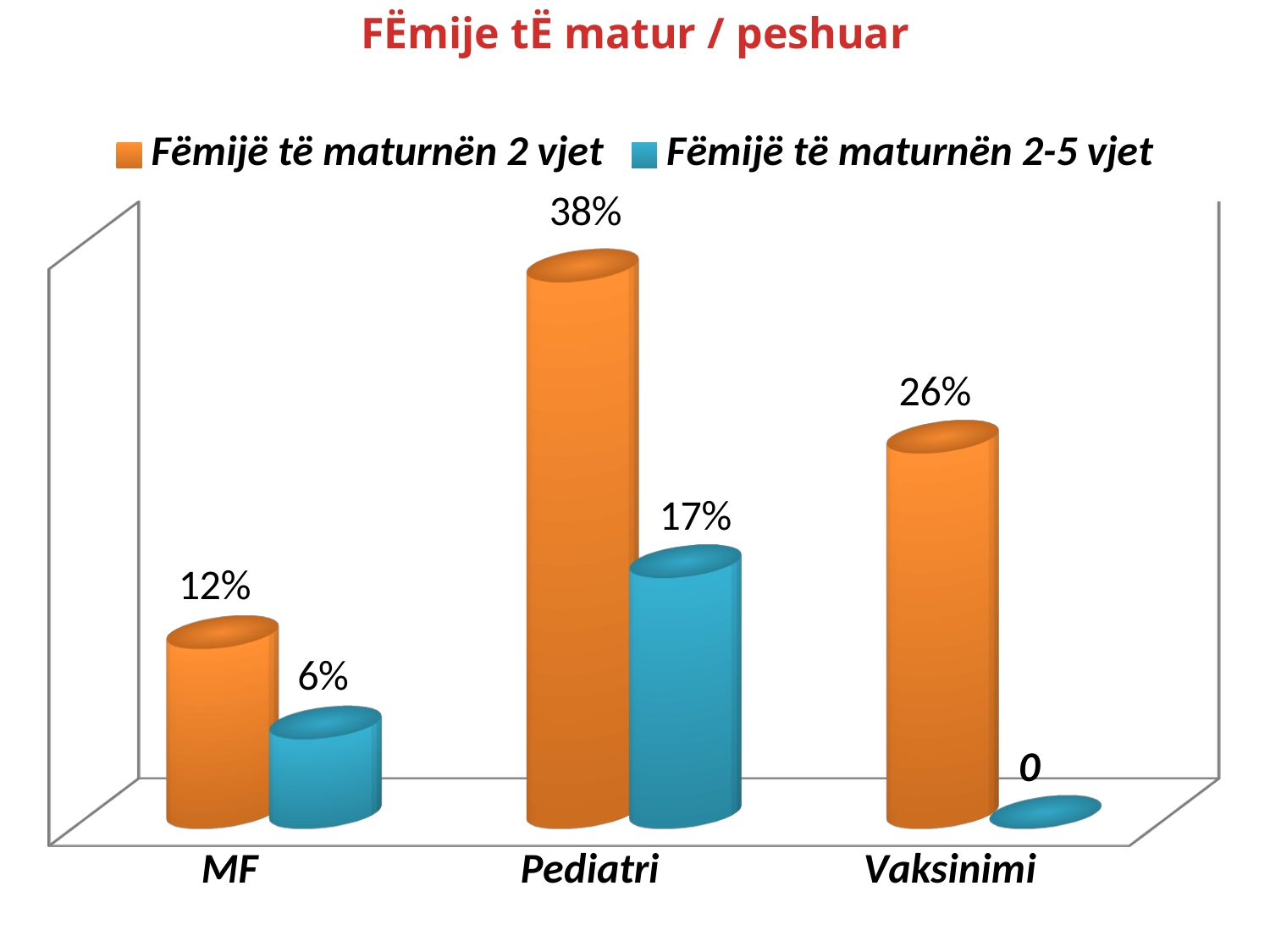
Which category has the highest value in the 'Fëmijë të maturnën 2 vjet' series? Pediatri What is the value for MF in the 'Fëmijë të maturnën 2-5 vjet' series? 6% What kind of chart is shown on the slide? Bar chart How many categories are shown on the x axis? 3 What is the difference between the two series for Pediatri? 21% Which is larger for MF: the 'Fëmijë të maturnën 2 vjet' value or the 'Fëmijë të maturnën 2-5 vjet' value? Fëmijë të maturnën 2 vjet Which category has the lowest value in the 'Fëmijë të maturnën 2-5 vjet' series? Vaksinimi What is the value for Pediatri in the 'Fëmijë të maturnën 2 vjet' series? 38% How many series does the legend list? 2 What is the value for Vaksinimi in the 'Fëmijë të maturnën 2 vjet' series? 26% What is the difference between the 'Fëmijë të maturnën 2 vjet' values for Pediatri and Vaksinimi? 12% What is the value for Vaksinimi in the 'Fëmijë të maturnën 2-5 vjet' series? 0